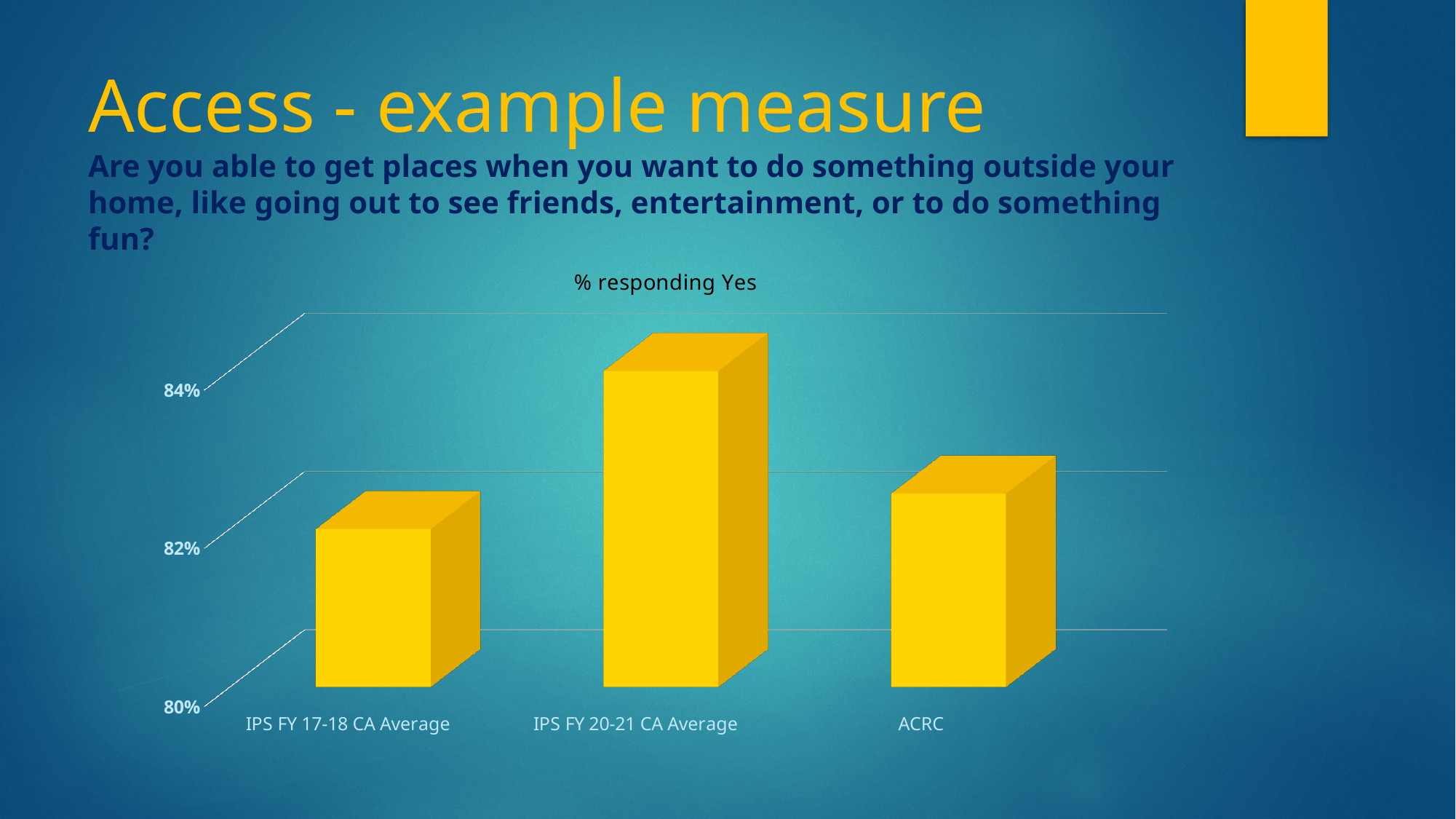
Which is larger, the value for IPS FY 20-21 CA Average or the value for ACRC? IPS FY 20-21 CA Average Is the value for ACRC greater or less than 84%? less Which is larger, the value for ACRC or the value for IPS FY 17-18 CA Average? ACRC Which category has the lowest value in the chart? IPS FY 17-18 CA Average What kind of chart is shown on the slide? bar chart What is the title of the chart? % responding Yes Is the value for IPS FY 17-18 CA Average greater or less than 80%? greater Is the value for IPS FY 20-21 CA Average greater or less than 82%? greater How many categories are plotted in the chart? 3 Which category has the highest value in the chart? IPS FY 20-21 CA Average What colour are the bars in the chart? yellow Does the value rise or fall from IPS FY 17-18 CA Average to IPS FY 20-21 CA Average? rise